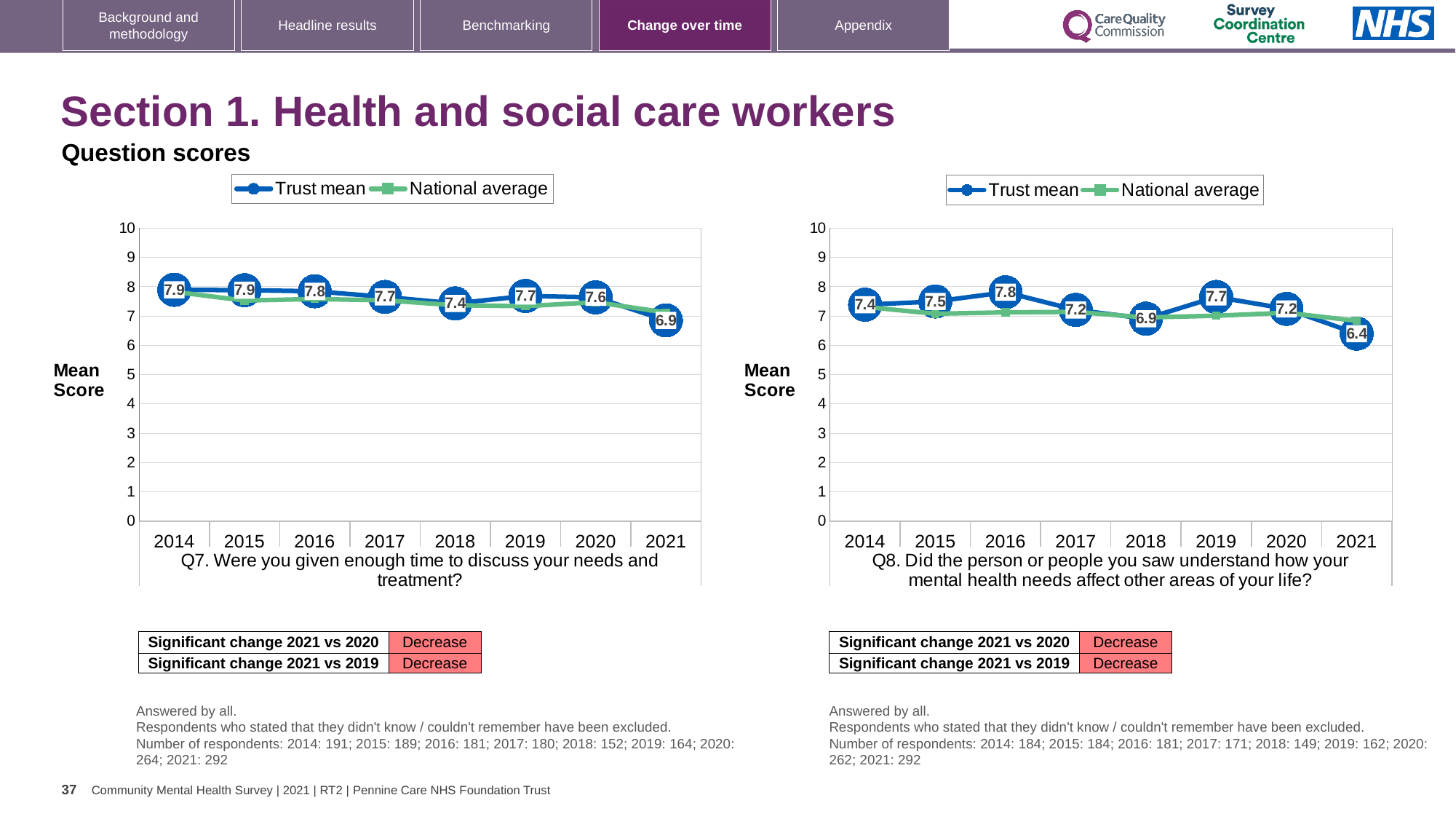
What type of chart is the Q7 chart (left)? Line chart How many series does the legend of the Q8 chart (right) list? 2 In the Q7 chart (left), what is the Trust mean for 2021? 6.9 In the Q7 chart (left), which year has the lowest Trust mean? 2021 In the Q8 chart (right), which year has the highest Trust mean? 2016 In the Q7 chart (left), what is the difference between the Trust mean in 2020 and in 2021? 0.7 How many years are shown on the x axis of the Q7 chart (left)? 8 In the Q8 chart (right), what is the difference between the Trust mean in 2016 and in 2021? 1.4 In the Q7 chart (left), is the Trust mean for 2021 greater or less than 7? less In the Q8 chart (right), is the Trust mean higher in 2019 or in 2018? 2019 In the Q8 chart (right), which year has the lowest Trust mean? 2021 In the Q8 chart (right), what is the Trust mean for 2016? 7.8